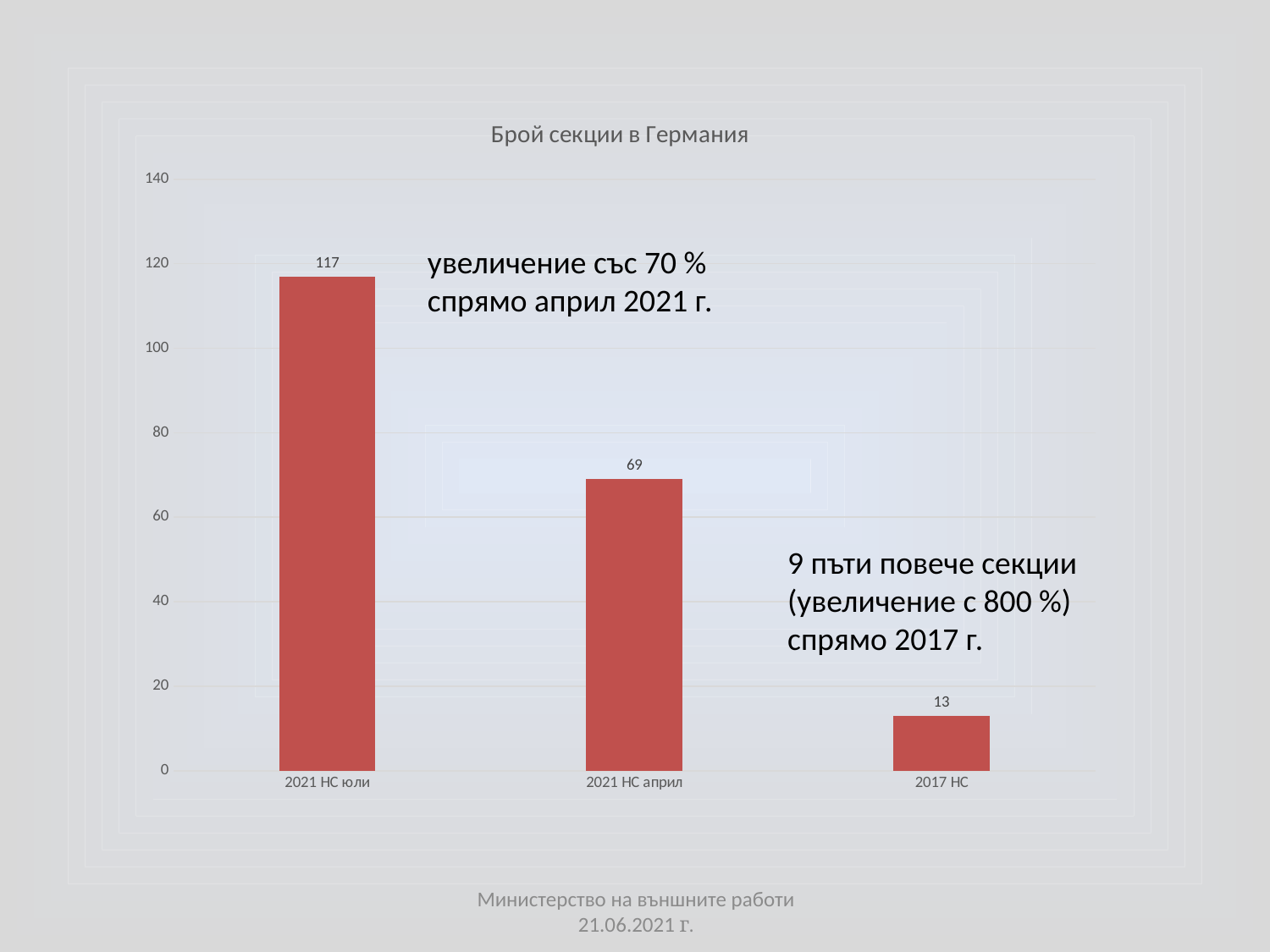
What is the value for 2021 НС април? 69 Which is larger, the value for 2021 НС април or the value for 2017 НС? 2021 НС април What is the title of the chart? Брой секции в Германия What is the value for 2017 НС? 13 What is the value for 2021 НС юли? 117 What is the difference between the values for 2021 НС юли and 2021 НС април? 48 Is the value for 2021 НС юли greater or less than 100? greater Which category has the lowest value? 2017 НС What is the difference between the values for 2021 НС април and 2017 НС? 56 Which category has the highest value? 2021 НС юли How many categories are shown on the chart? 3 What kind of chart is shown on the slide? bar chart